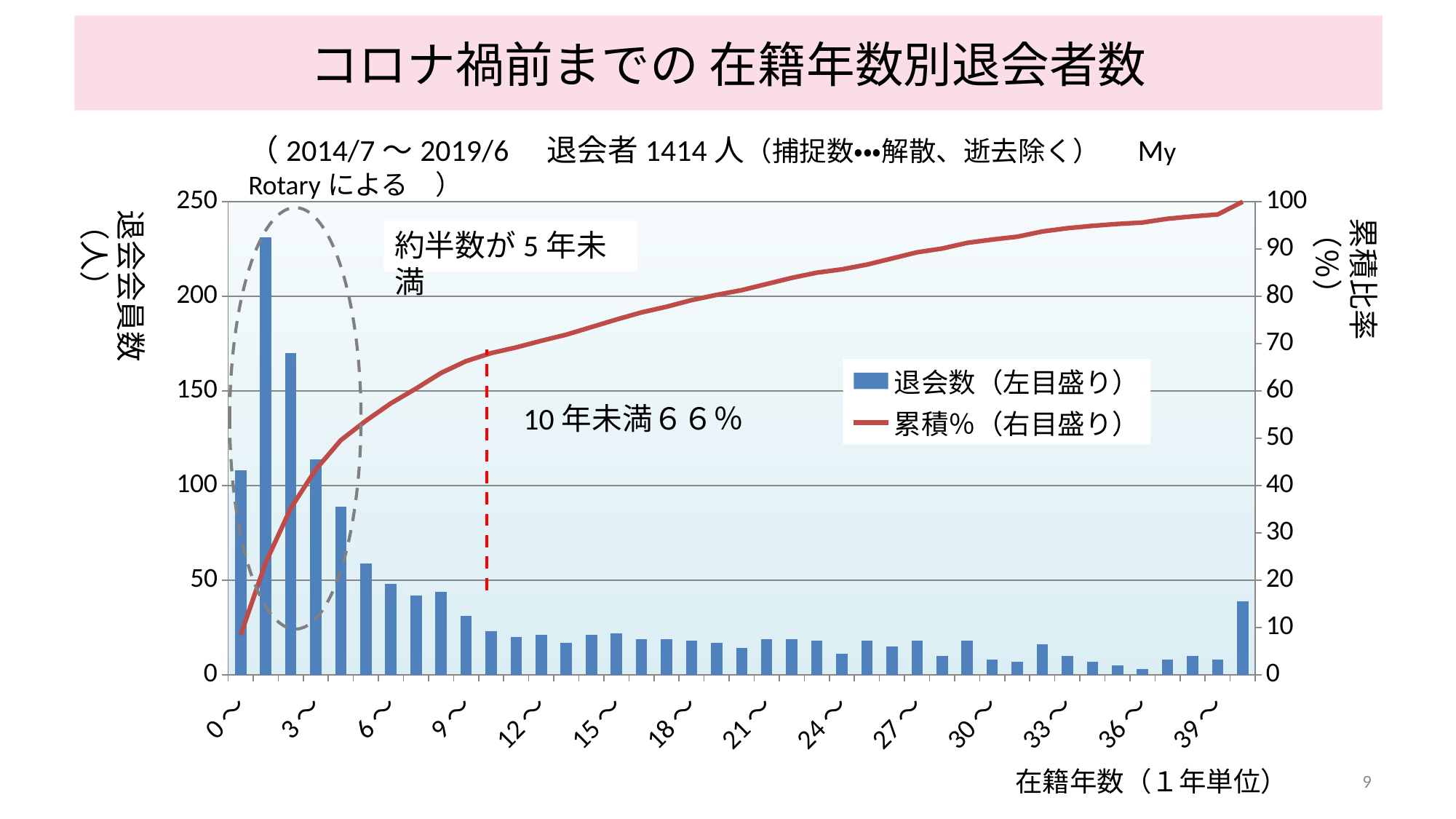
Is the 退会数 value for 12〜 greater or less than 50? less What is the title of the slide's chart? コロナ禍前までの 在籍年数別退会者数 What are the two legend entries of the chart? 退会数（左目盛り） and 累積%（右目盛り） How many series does the legend list? 2 Which has a larger 退会数 value, 3〜 or 6〜? 3〜 Does the 累積% line rise or fall as 在籍年数 increases along the x axis? rise Is the 退会数 value for 3〜 greater or less than 100? greater Is the 累積% value at 9〜 greater or less than 60? greater How many category labels are printed on the x axis? 14 Which has a larger 退会数 value, 0〜 or 9〜? 0〜 What kind of chart is shown on the slide? A combination of a bar chart and a line chart